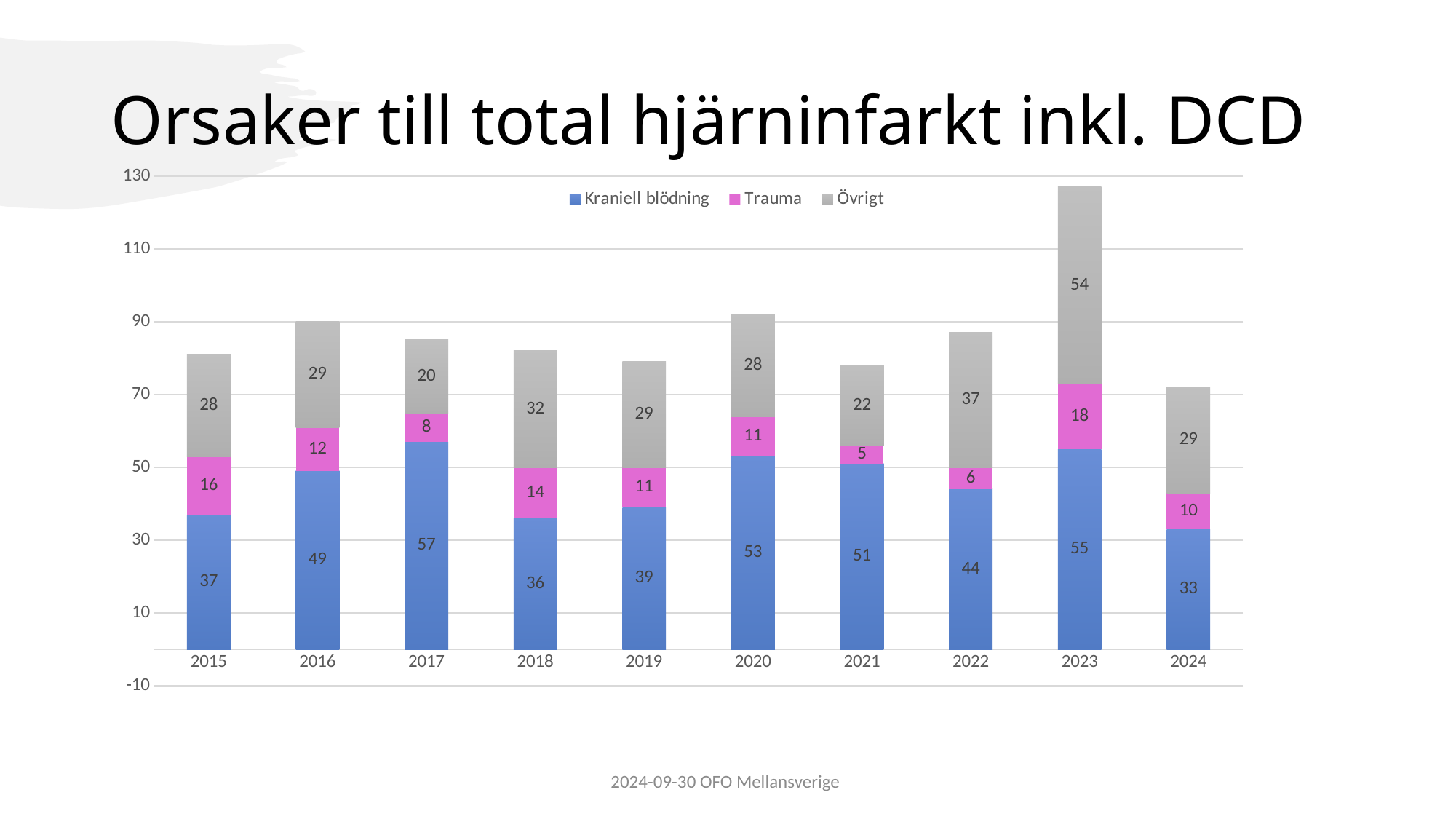
How many series does the legend list? 3 What is the Trauma value for 2021? 5 What is the total of the stacked bar for 2023? 127 Which year has the highest Kraniell blödning value? 2017 What is the value for Kraniell blödning in 2017? 57 What is the total of the stacked bar for 2024? 72 How many years are shown on the x axis? 10 What is the difference between the Kraniell blödning values for 2023 and 2024? 22 Is the Trauma value larger in 2015 or in 2016? 2015 What is the Övrigt value for 2023? 54 Which year has the lowest Trauma value? 2021 Which year has the lowest Övrigt value? 2017